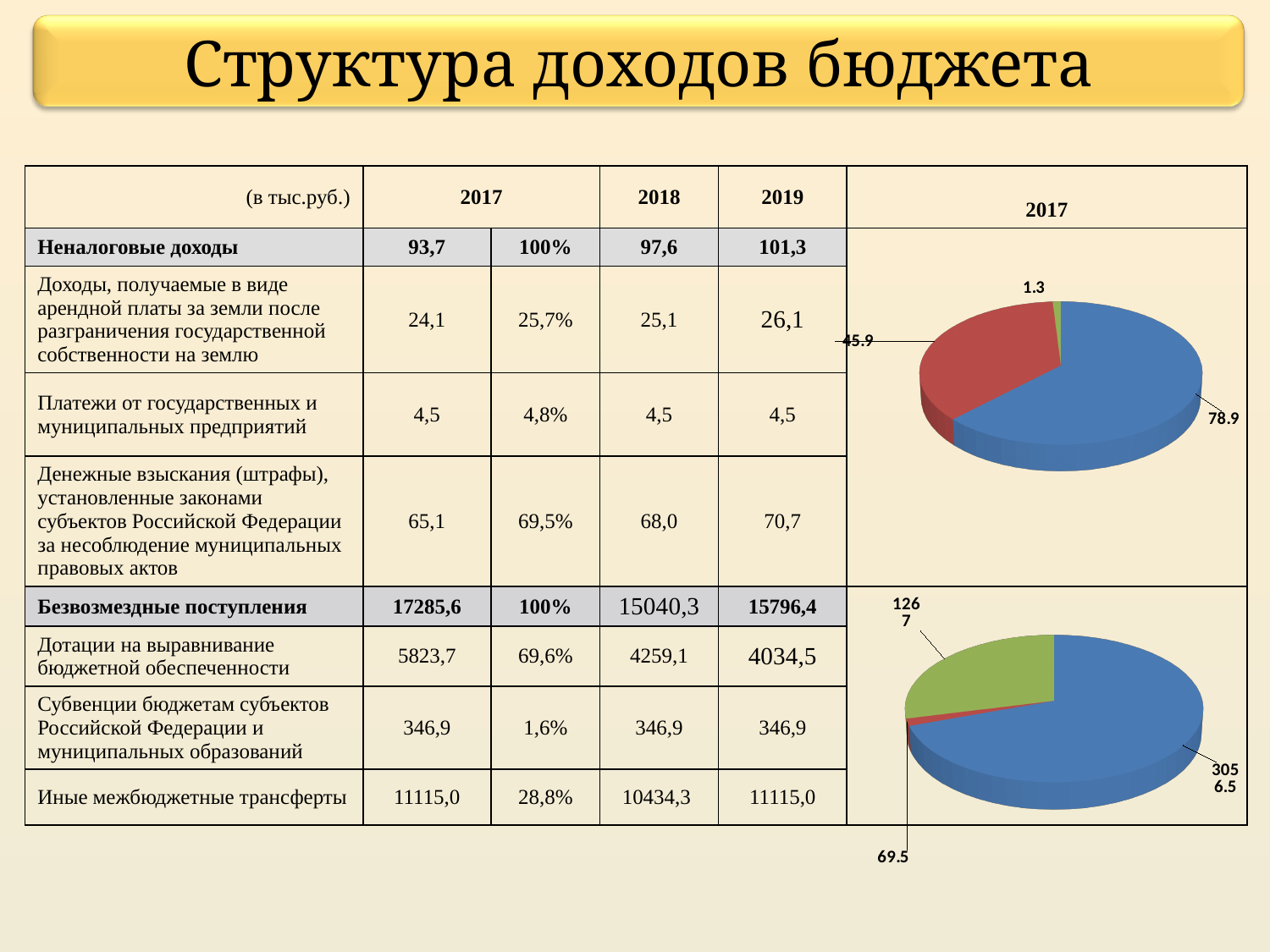
In the bottom pie chart, which slice is the largest? the blue slice What is the title of the top pie chart? 2017 In the top pie chart, which colour is the largest slice? blue In the bottom pie chart, which slice is the smallest? the red slice In the top pie chart, what value is labelled on the red slice? 45.9 In the top pie chart, is the slice labelled 45.9 larger or smaller than the slice labelled 78.9? smaller What kind of chart is the bottom chart on the right of the slide? pie chart What kind of chart is the top chart on the right of the slide? pie chart In the top pie chart, what is the largest data label shown? 78.9 How many slices does the top pie chart have? 3 In the top pie chart, what is the smallest data label shown? 1.3 How many slices does the bottom pie chart have? 3